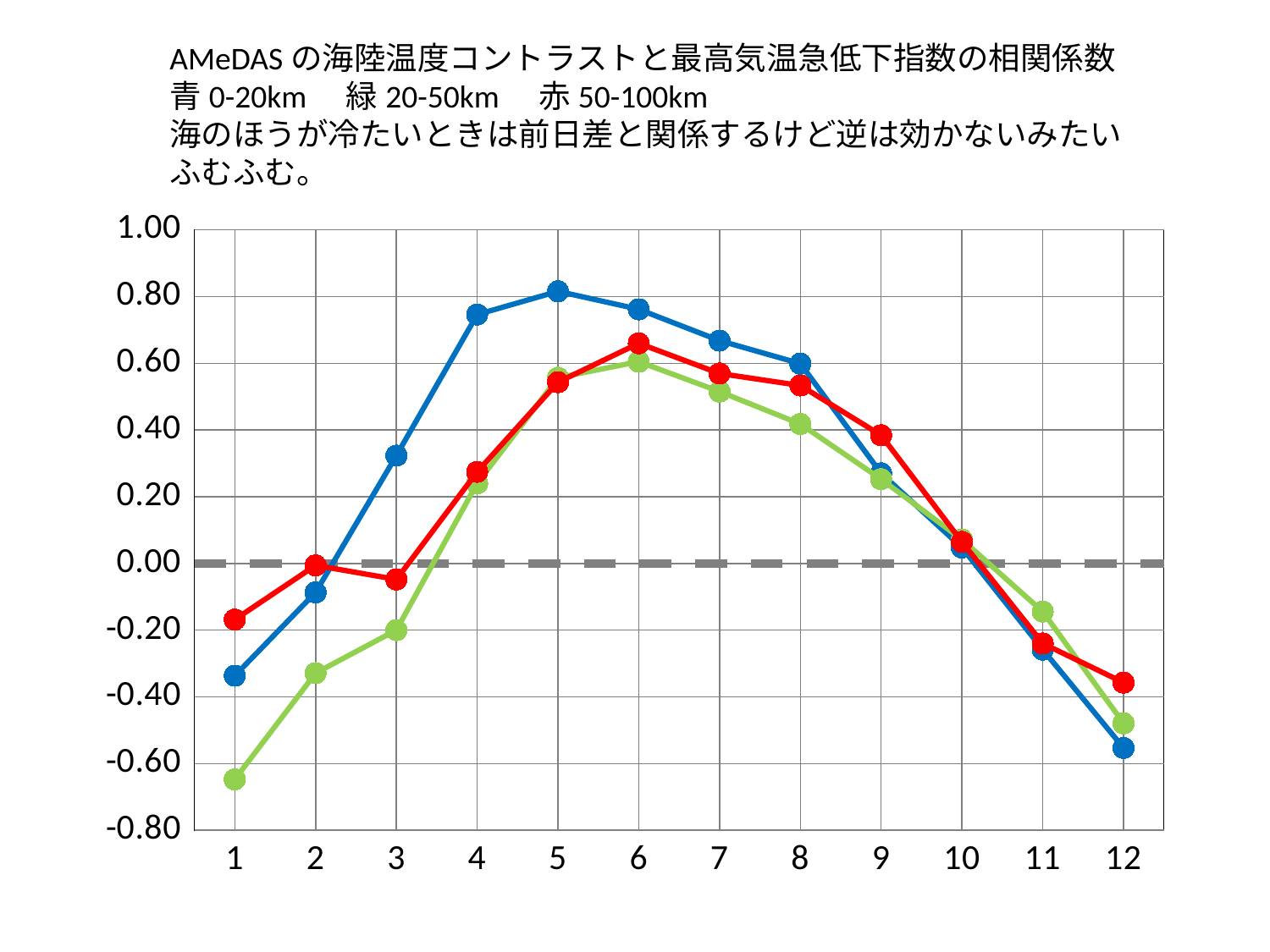
Does the blue line rise or fall from x = 5 to x = 12? fall How many lines (series) are plotted in the chart? 3 Is the value of the green line at x = 1 greater or less than -0.60? less At which x value does the blue line (0-20km) reach its highest value? 5 Is the value of the blue line at x = 4 greater or less than 0.60? greater How many points are plotted along the x axis for each line? 12 At which x value does the blue line (0-20km) reach its lowest value? 12 Is the value of the red line at x = 12 greater or less than -0.20? less What kind of chart is shown on the slide? line chart According to the slide text, which colour represents the 0-20km series? 青 (blue) At which x value does the green line (20-50km) reach its lowest value? 1 At x = 3, which line has the higher value, the blue line or the green line? blue line